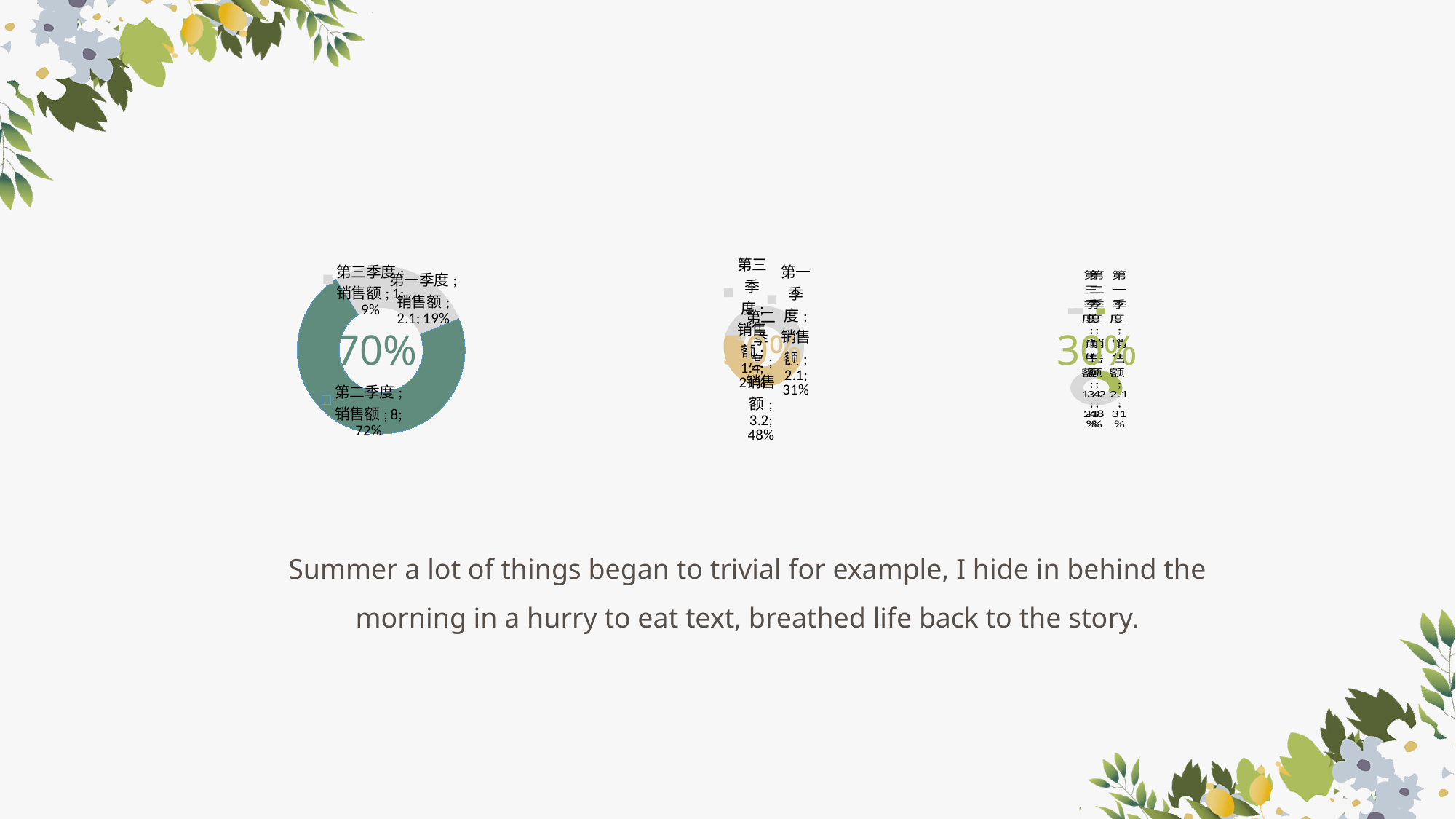
In the left doughnut chart, which quarter has the smallest 销售额? 第三季度 How many categories does the left doughnut chart show? 3 In the left doughnut chart, what is the 销售额 value for 第二季度? 8 What percentage is printed in the centre of the left doughnut chart? 70% In the left doughnut chart, what is the 销售额 value for 第三季度? 1 What kind of chart is the left chart on the slide? Doughnut chart In the left doughnut chart, what share of the whole does 第二季度 represent? 72% In the left doughnut chart, what is the difference between the 销售额 for 第二季度 and 第一季度? 5.9 In the left doughnut chart, what share of the whole does 第三季度 represent? 9% In the left doughnut chart, what is the 销售额 value for 第一季度? 2.1 In the left doughnut chart, which is larger, the 销售额 for 第一季度 or for 第三季度? 第一季度 In the left doughnut chart, which quarter has the largest 销售额? 第二季度